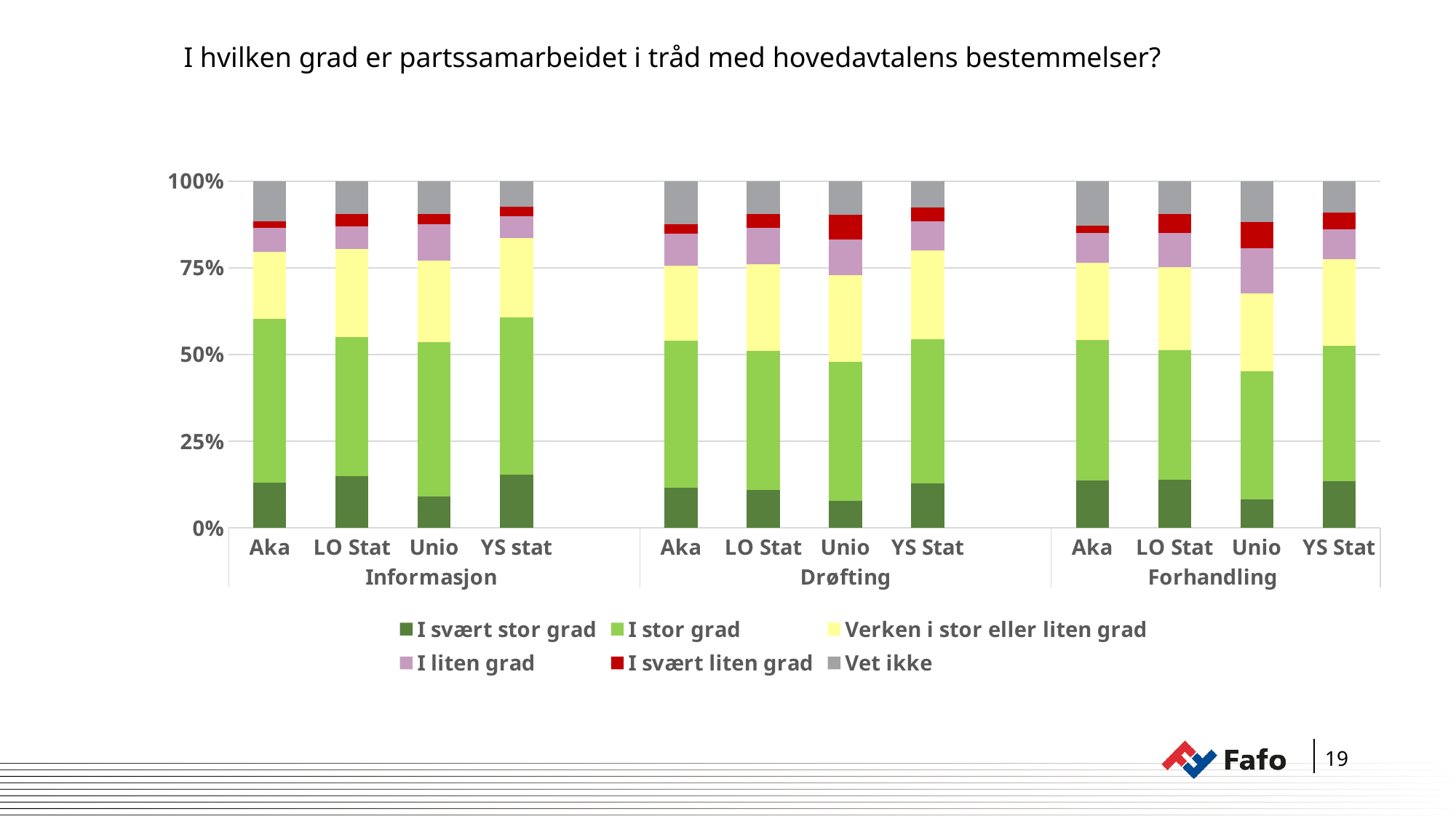
What is the title of the chart? I hvilken grad er partssamarbeidet i tråd med hovedavtalens bestemmelser? In the Drøfting group, which category has the lowest value for 'I svært stor grad'? Unio Is the value of 'I svært stor grad' for Aka in the Informasjon group greater or less than 25%? less Is the value of 'I svært stor grad' for Unio in the Forhandling group greater or less than 25%? less What kind of chart is shown on the slide? Stacked bar chart Which legend entry is shown in red? I svært liten grad In the Forhandling group, which category has the lowest value for 'I svært stor grad'? Unio In the Informasjon group, which is larger for 'I svært stor grad': LO Stat or Unio? LO Stat How many bars are plotted in the chart? 12 How many series does the legend list? 6 What is the total of the stacked bar for YS Stat in the Drøfting group? 100% How many groups are shown along the x axis? 3